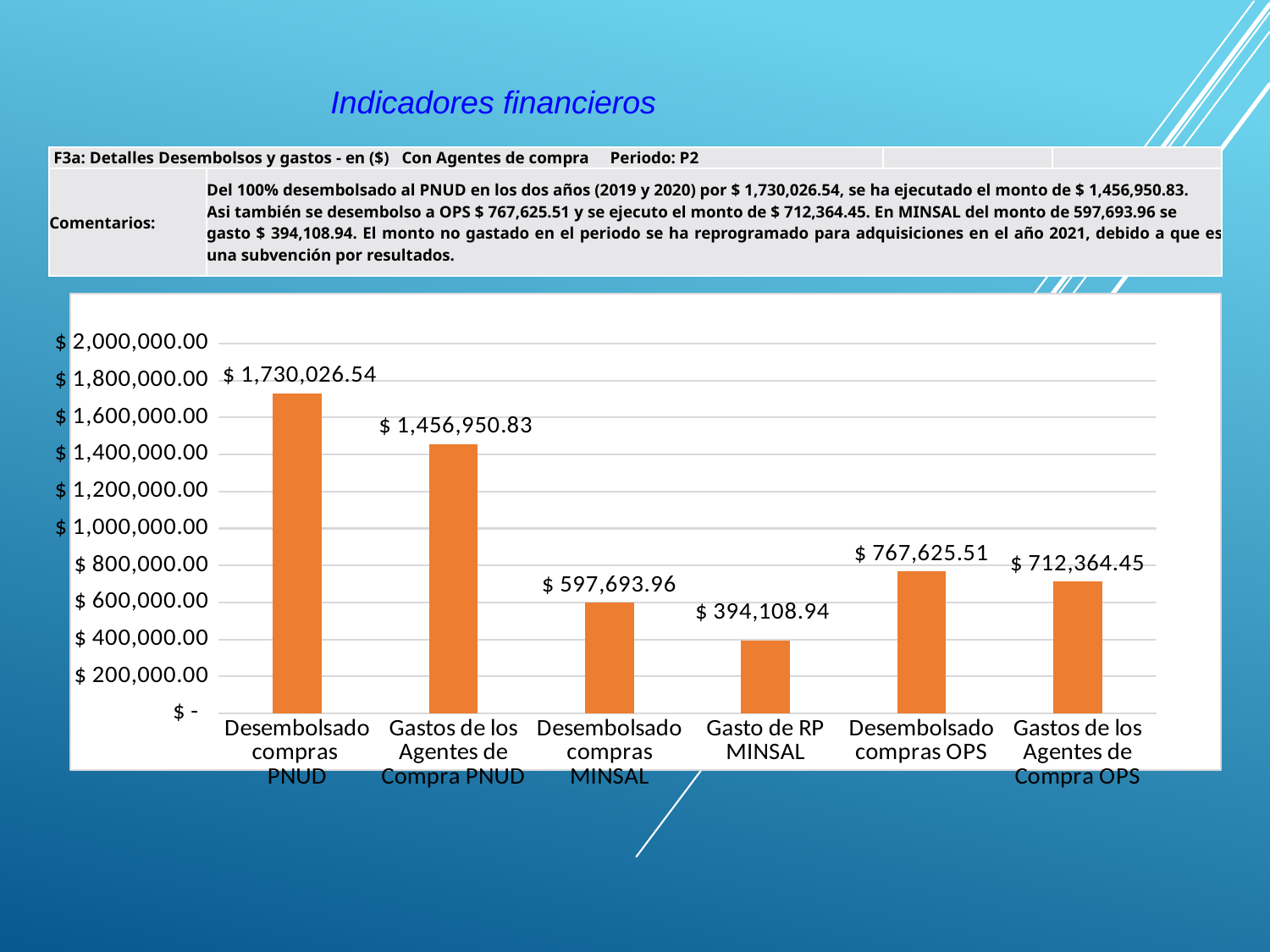
What is the difference between Desembolsado compras MINSAL and Gasto de RP MINSAL? $ 203,585.02 Which is larger, Desembolsado compras OPS or Desembolsado compras MINSAL? Desembolsado compras OPS Is the value for Gastos de los Agentes de Compra PNUD greater or less than $ 1,400,000.00? greater Which category has the highest value? Desembolsado compras PNUD What is the difference between Desembolsado compras PNUD and Gastos de los Agentes de Compra PNUD? $ 273,075.71 What is the value for Desembolsado compras OPS? $ 767,625.51 What kind of chart is shown on the slide? bar chart What is the value for Gastos de los Agentes de Compra OPS? $ 712,364.45 How many categories are shown in the chart? 6 What is the value for Gasto de RP MINSAL? $ 394,108.94 Which category has the lowest value? Gasto de RP MINSAL What is the value for Desembolsado compras PNUD? $ 1,730,026.54